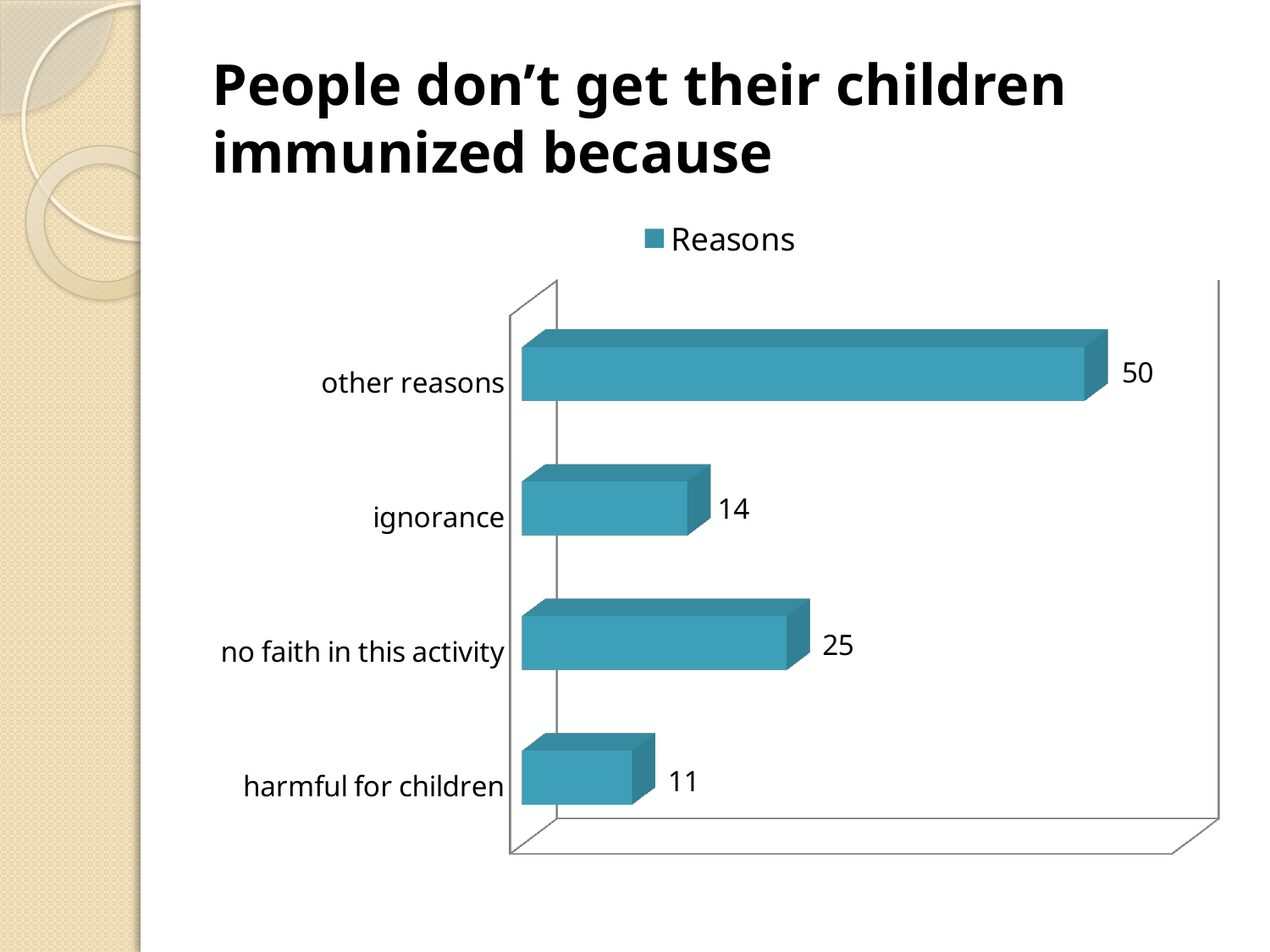
What is the value for "no faith in this activity"? 25 What is the difference between the values for "ignorance" and "harmful for children"? 3 How many categories are shown in the chart? 4 What series name does the legend show? Reasons Which category has the lowest value? harmful for children What is the value for "other reasons"? 50 Which category has the highest value? other reasons What is the value for "harmful for children"? 11 What kind of chart is shown on the slide? bar chart What is the value for "ignorance"? 14 Which is larger, the value for "ignorance" or the value for "no faith in this activity"? no faith in this activity What is the difference between the values for "other reasons" and "no faith in this activity"? 25